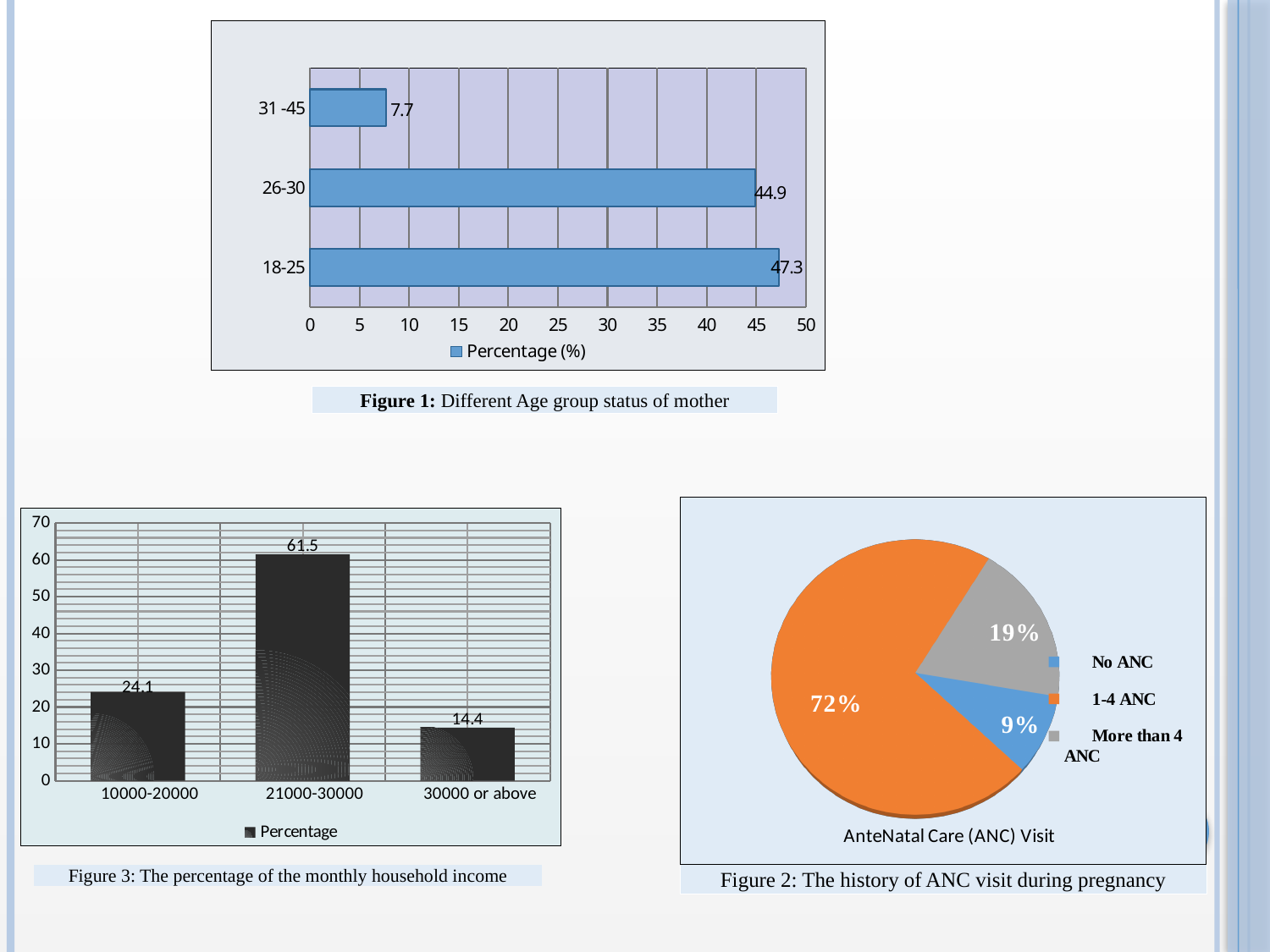
In the Figure 1 chart (Different Age group status of mother), which age group has the lowest percentage? 31 -45 In the Figure 1 chart (Different Age group status of mother), what is the percentage for the 26-30 age group? 44.9 In the Figure 3 chart (monthly household income), what is the percentage for the 21000-30000 income group? 61.5 In the Figure 2 pie chart (history of ANC visit during pregnancy), what share is 1-4 ANC? 72% What type of chart is the Figure 1 chart (Different Age group status of mother)? Bar chart In the Figure 3 chart (monthly household income), which income group has the highest percentage? 21000-30000 In the Figure 1 chart (Different Age group status of mother), how many age groups are shown? 3 In the Figure 3 chart (monthly household income), what is the difference between the 10000-20000 and 30000 or above percentages? 9.7 In the Figure 2 pie chart (history of ANC visit during pregnancy), which category has the smallest slice? No ANC In the Figure 1 chart (Different Age group status of mother), what is the difference between the 18-25 and 26-30 percentages? 2.4 In the Figure 3 chart (monthly household income), which is larger: the value for 10000-20000 or the value for 30000 or above? 10000-20000 In the Figure 2 pie chart (history of ANC visit during pregnancy), how many categories does the legend list? 3